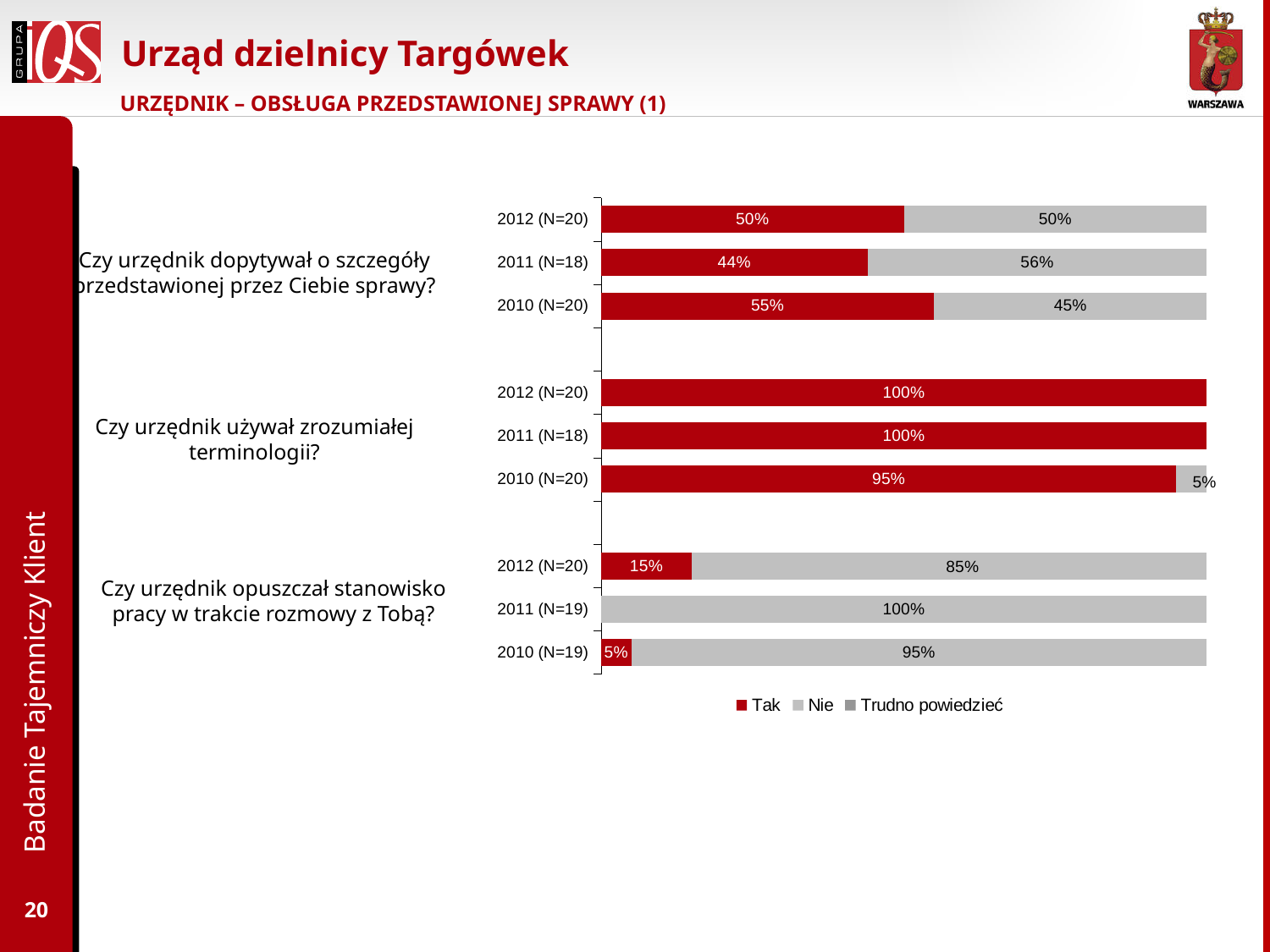
For the question 'Czy urzędnik używał zrozumiałej terminologii?', what is the 'Tak' value for 2010 (N=20)? 95% For the question 'Czy urzędnik dopytywał o szczegóły przedstawionej przez Ciebie sprawy?', what is the 'Nie' value for 2011 (N=18)? 56% What type of chart is shown on the slide? stacked bar chart For the question 'Czy urzędnik opuszczał stanowisko pracy w trakcie rozmowy z Tobą?', what is the 'Tak' value for 2012 (N=20)? 15% For the question 'Czy urzędnik dopytywał o szczegóły przedstawionej przez Ciebie sprawy?', what is the 'Tak' value for 2012 (N=20)? 50% For the question 'Czy urzędnik dopytywał o szczegóły przedstawionej przez Ciebie sprawy?', which year has the highest 'Tak' share? 2010 (N=20) For the question 'Czy urzędnik używał zrozumiałej terminologii?', what is the 'Tak' value for 2012 (N=20)? 100% How many series does the chart legend list? 3 For the question 'Czy urzędnik dopytywał o szczegóły przedstawionej przez Ciebie sprawy?', what is the difference between the 'Tak' values for 2010 (N=20) and 2011 (N=18)? 11 percentage points What are the legend entries of the chart? Tak, Nie, Trudno powiedzieć For the question 'Czy urzędnik opuszczał stanowisko pracy w trakcie rozmowy z Tobą?', what is the 'Nie' value for 2011 (N=19)? 100% For the question 'Czy urzędnik opuszczał stanowisko pracy w trakcie rozmowy z Tobą?', is the 'Tak' value larger in 2012 (N=20) or in 2010 (N=19)? 2012 (N=20)